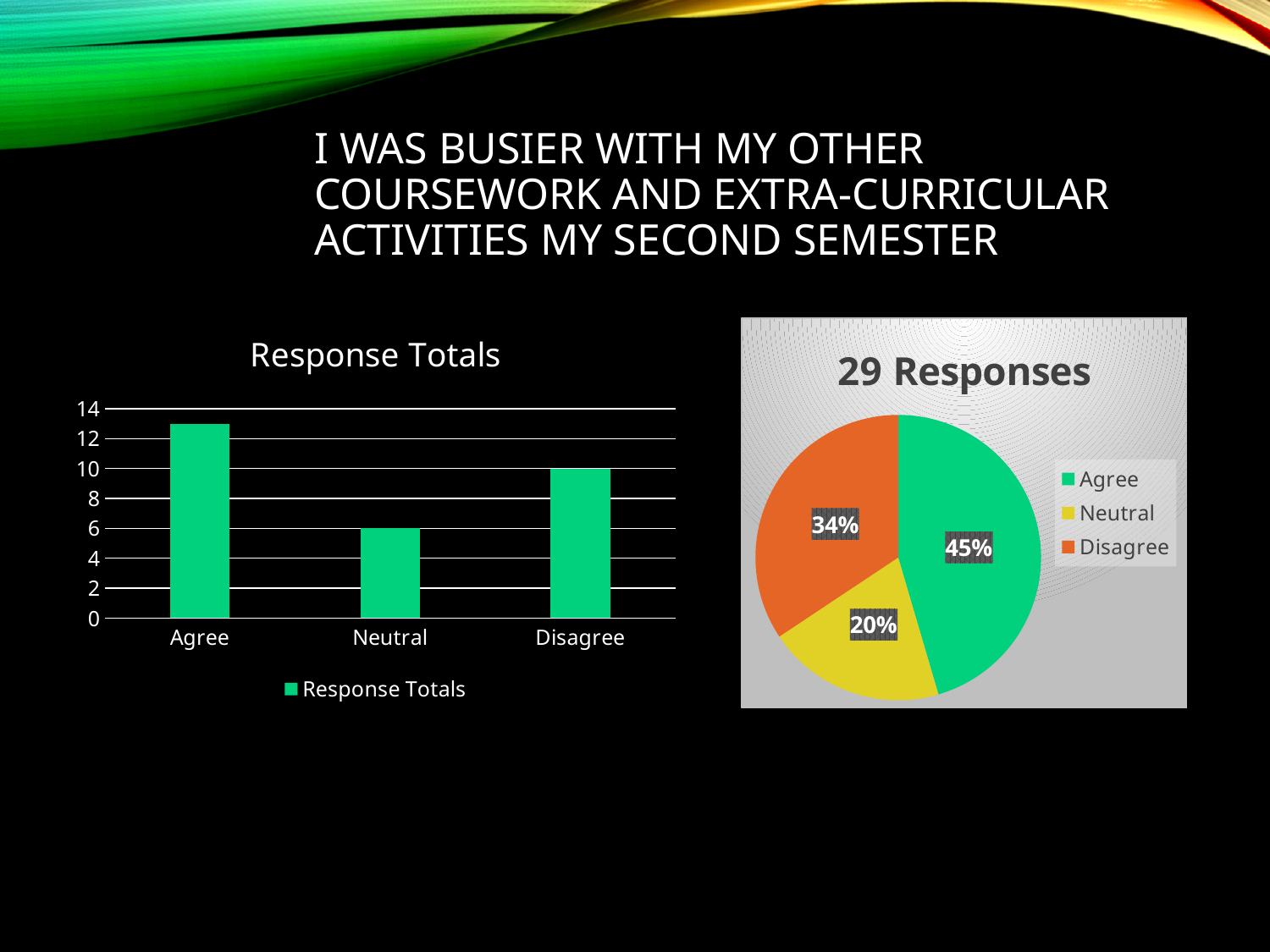
In the Response Totals bar chart, which category has the lowest value? Neutral In the Response Totals bar chart, what is the difference between the values for Disagree and Neutral? 4 In the Response Totals bar chart, which is larger, the value for Disagree or the value for Neutral? Disagree In the Response Totals bar chart, which category has the highest value? Agree How many entries does the legend of the 29 Responses pie chart list? 3 How many categories are shown in the Response Totals bar chart? 3 In the Response Totals bar chart, what is the value for Disagree? 10 In the Response Totals bar chart, is the value for Agree greater or less than 12? greater In the 29 Responses pie chart, what share does Disagree have? 34% In the Response Totals bar chart, what is the value for Neutral? 6 What kind of chart is the Response Totals chart on the left? bar chart In the 29 Responses pie chart, what share does Agree have? 45%